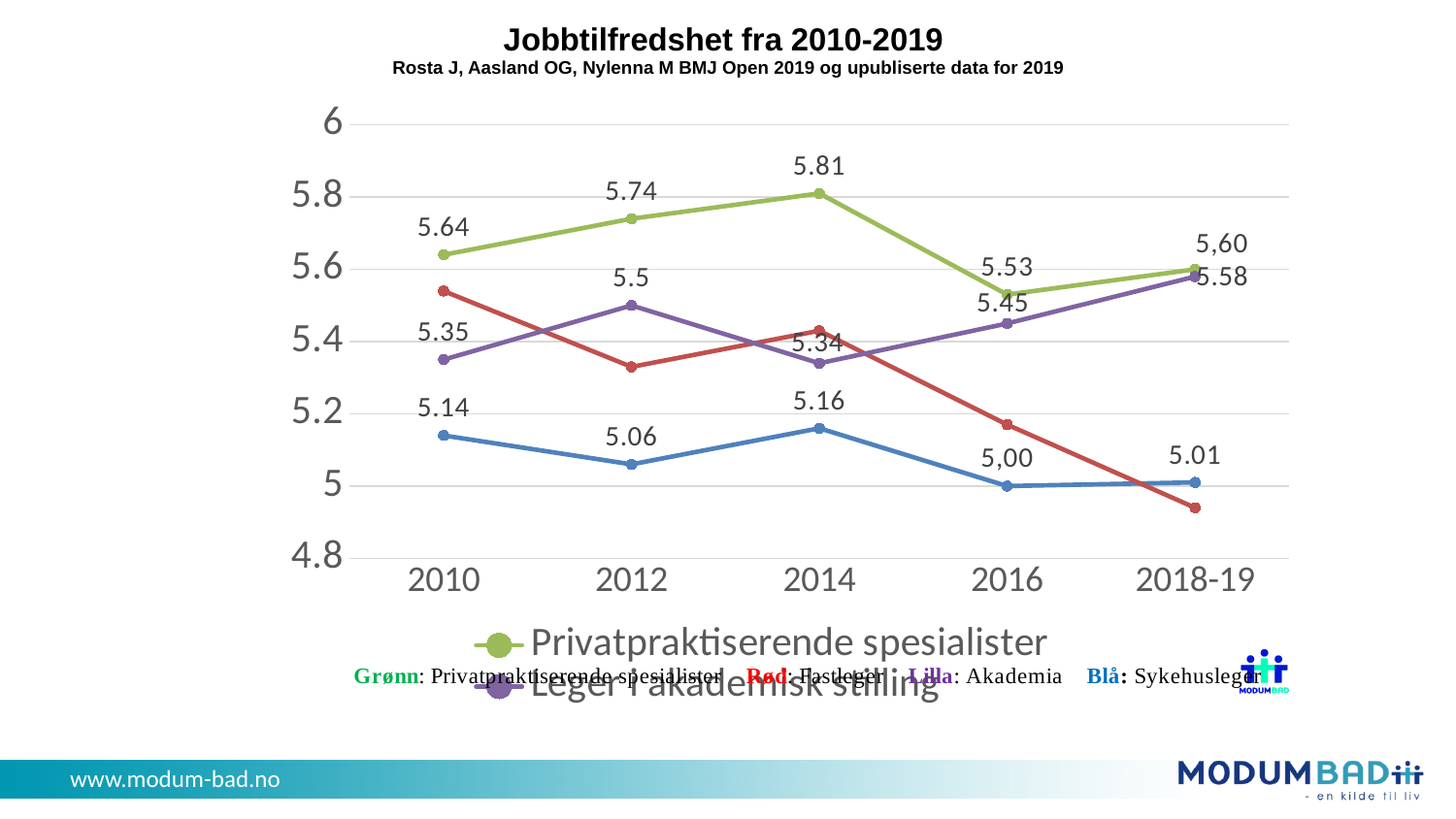
In which year does the blue line (Sykehusleger) have its lowest value? 2016 What is the value for Akademia (purple line) in 2012? 5.5 What is the value for Privatpraktiserende spesialister (green line) in 2018-19? 5,60 How much higher is the green line's value in 2014 than in 2010? 0.17 What is the value for Privatpraktiserende spesialister (green line) in 2014? 5.81 Does the red line (Fastleger) rise or fall from 2010 to 2018-19? fall In 2012, which is higher: the green line (Privatpraktiserende spesialister) or the purple line (Akademia)? Privatpraktiserende spesialister (green) How many time points are shown on the x axis? 5 In which year does the green line (Privatpraktiserende spesialister) reach its highest value? 2014 Is the value for the red line (Fastleger) in 2018-19 greater or less than 5? less What kind of chart is shown on the slide? line chart What is the value for Sykehusleger (blue line) in 2016? 5,00